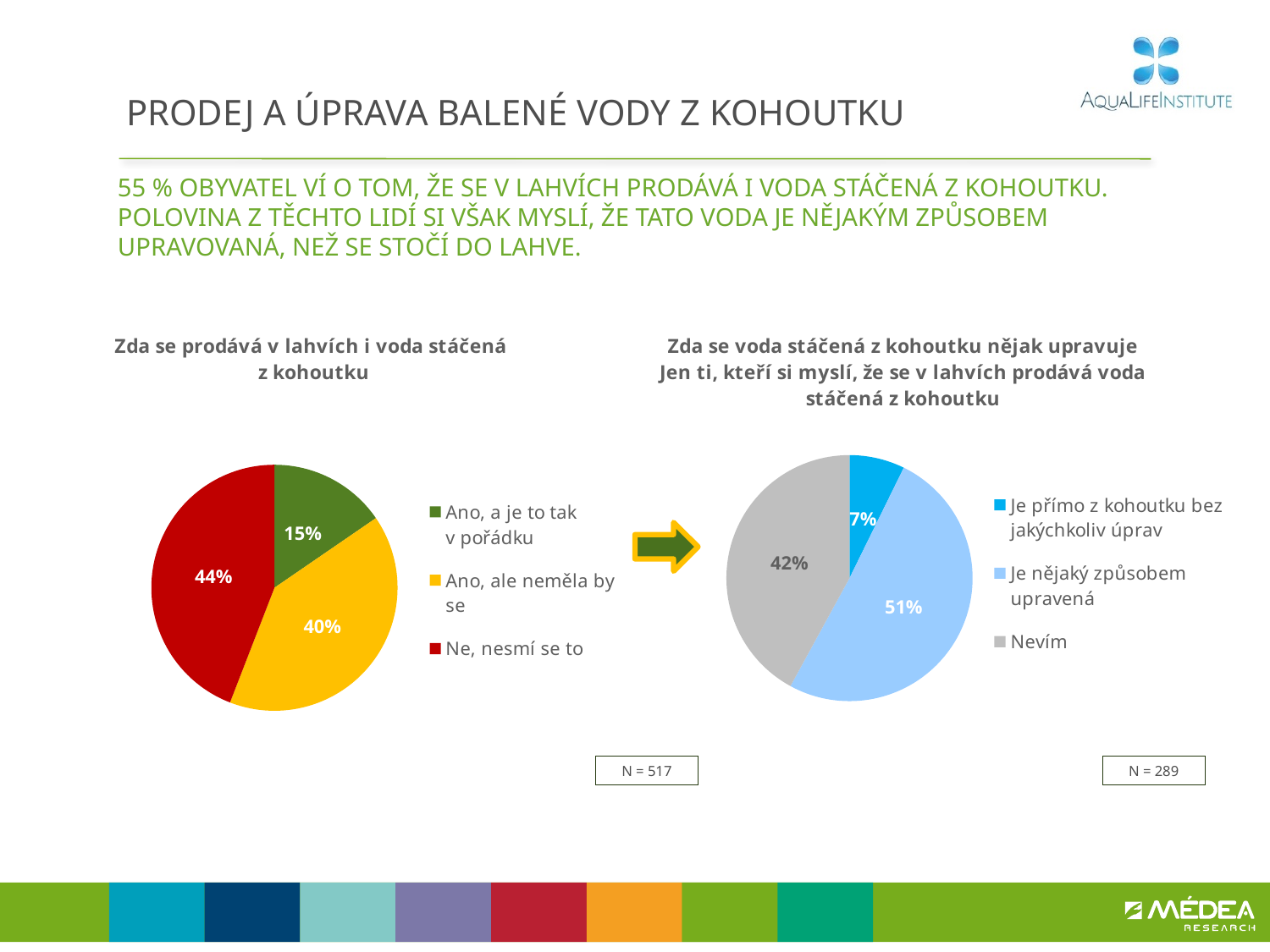
What type of chart is used on the right side of the slide? Pie chart In the left pie chart, what share of respondents answered "Ano, a je to tak v pořádku"? 15% In the left pie chart, what is the difference between the shares for "Ne, nesmí se to" and "Ano, ale neměla by se"? 4 percentage points How many slices does the left pie chart have? 3 In the right pie chart, what share of respondents answered "Nevím"? 42% In the left pie chart, what share of respondents answered "Ne, nesmí se to"? 44% What is the sample size (N) shown under the right pie chart? N = 289 In the right pie chart, what is the difference between the shares for "Je nějaký způsobem upravená" and "Nevím"? 9 percentage points In the right pie chart, which answer has the smallest share? Je přímo z kohoutku bez jakýchkoliv úprav In the right pie chart, what share of respondents answered "Je nějaký způsobem upravená"? 51% In the right pie chart, which is larger: the share for "Je nějaký způsobem upravená" or the share for "Nevím"? Je nějaký způsobem upravená In the left pie chart, which answer has the largest share? Ne, nesmí se to